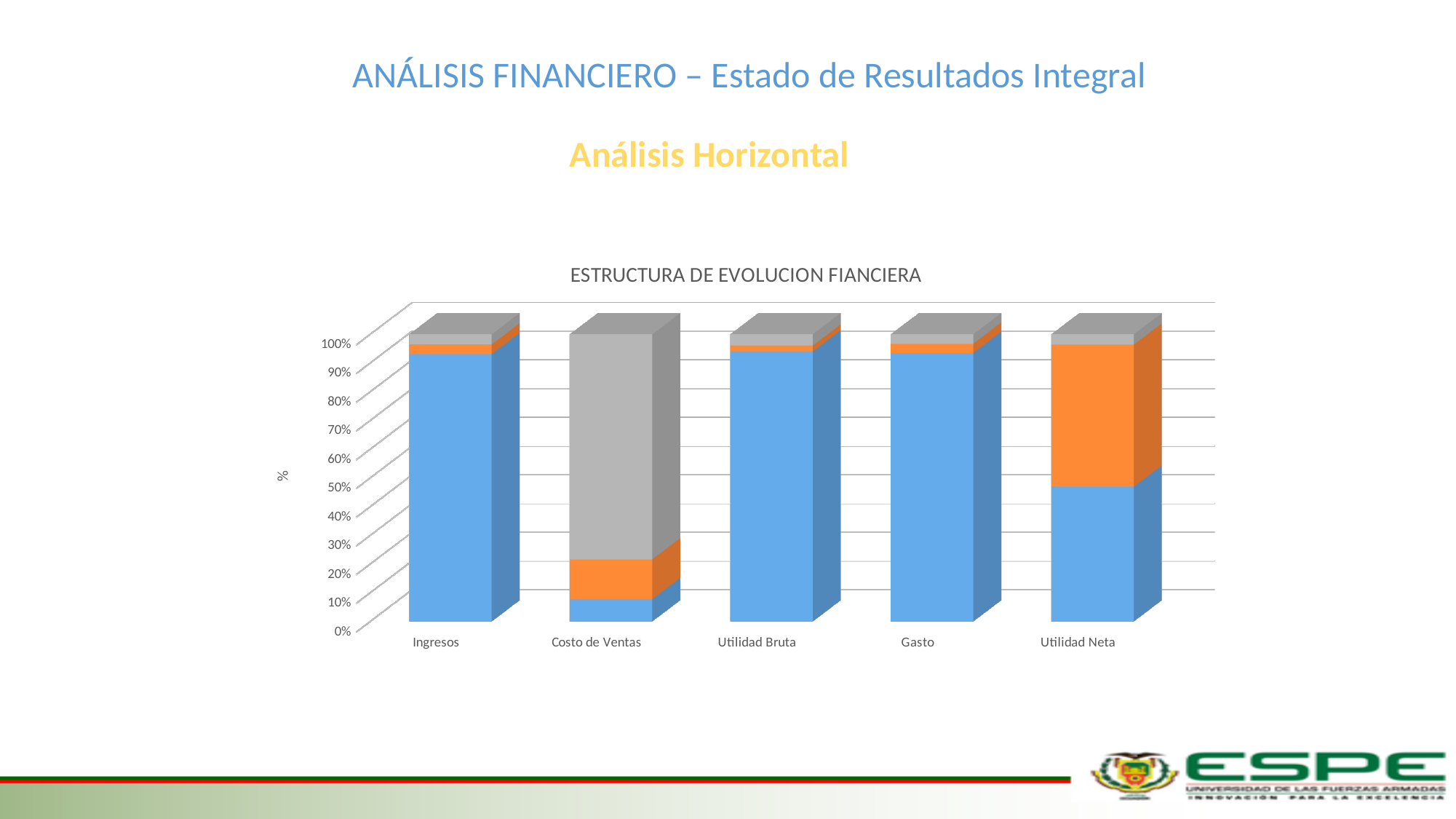
What is the label on the vertical axis of the chart? % Is the blue segment for Costo de Ventas greater or less than 30%? less Is the gray segment for Costo de Ventas greater or less than 50%? greater What type of chart is shown on the slide? Stacked bar chart Which category has the largest gray segment? Costo de Ventas Which category has the smallest blue segment? Costo de Ventas Which category has the largest orange segment? Utilidad Neta Which has the larger blue segment, Ingresos or Costo de Ventas? Ingresos What is the title of the chart? ESTRUCTURA DE EVOLUCION FIANCIERA Is the blue segment for Utilidad Neta greater or less than 40%? greater How many categories are shown on the x axis of the chart? 5